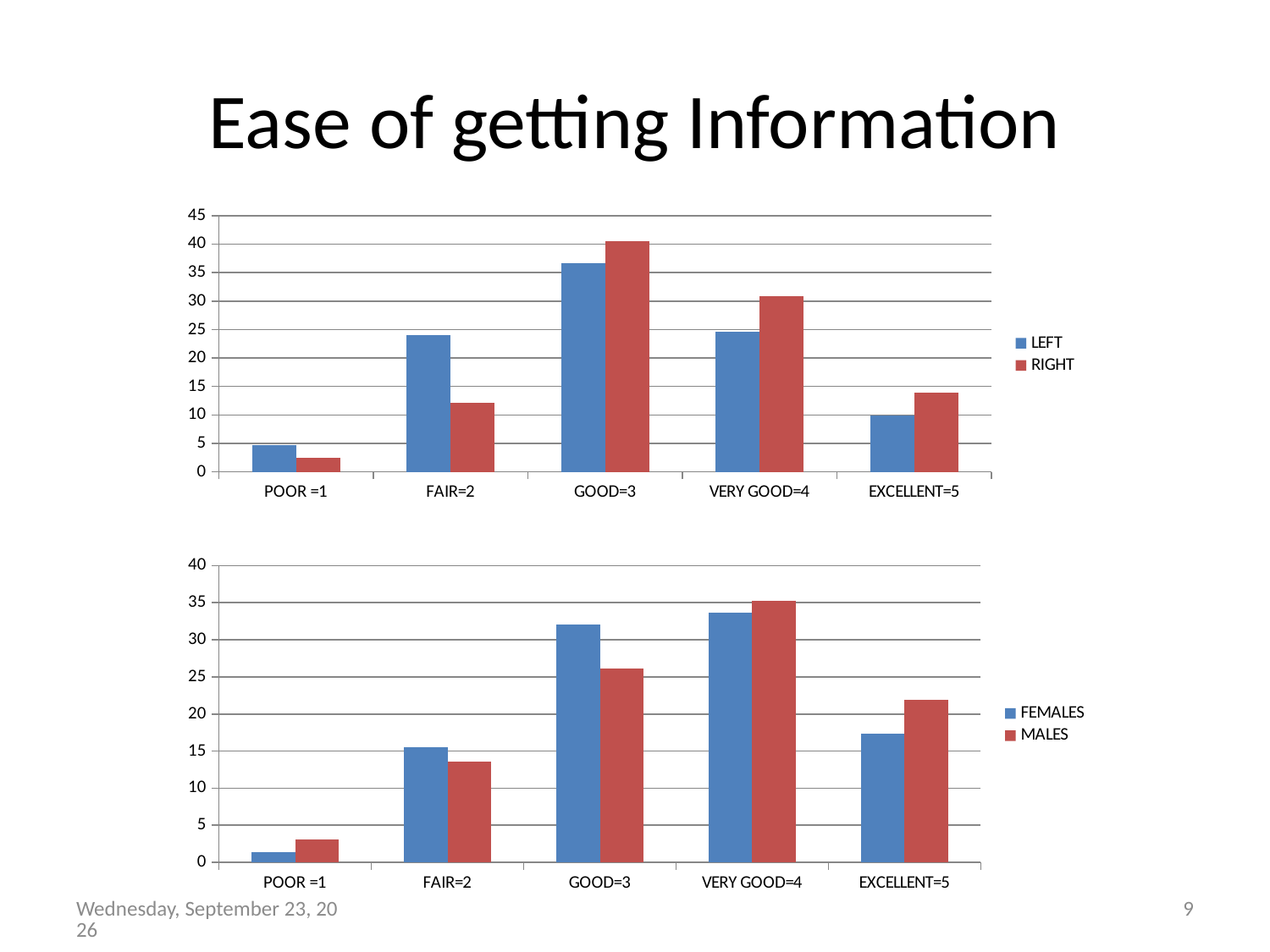
In the bottom chart, which is larger for EXCELLENT=5, FEMALES or MALES? MALES In the bottom chart, which category has the highest MALES value? VERY GOOD=4 In the top chart, which category has the highest RIGHT value? GOOD=3 In the top chart, which category has the lowest LEFT value? POOR =1 How many series does the legend of the top chart list? 2 What are the two series named in the legend of the bottom chart? FEMALES and MALES What kind of chart is the top chart on the slide? bar chart In the bottom chart, is the FEMALES value for GOOD=3 greater or less than 30? greater How many categories are shown on the x axis of the bottom chart? 5 In the top chart, is the RIGHT value for FAIR=2 greater or less than 15? less In the top chart, is the LEFT value for GOOD=3 greater or less than 35? greater In the top chart, which is larger for FAIR=2, LEFT or RIGHT? LEFT